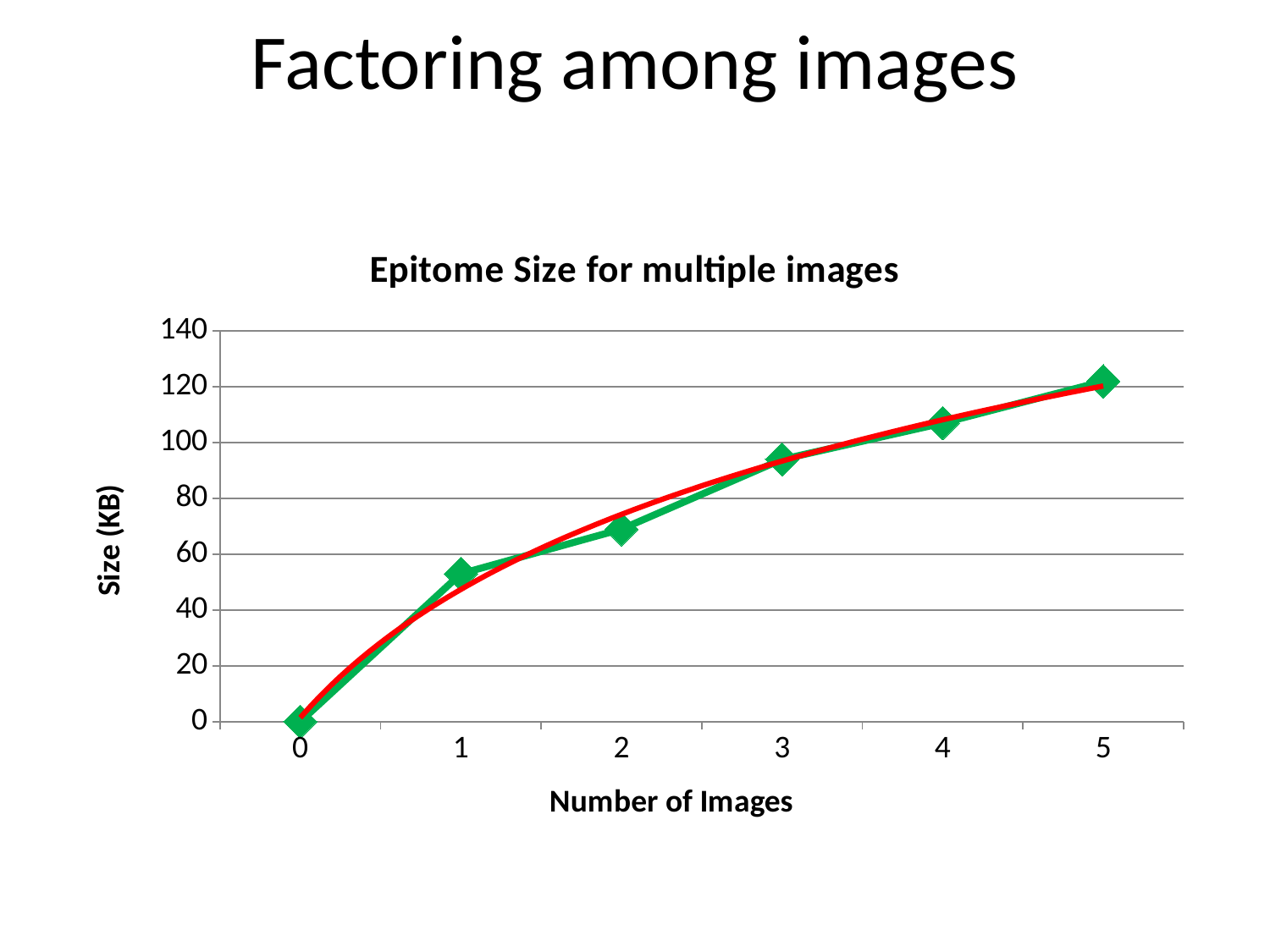
What is the size in KB for 0 images? 0 Is the value for 1 image greater or less than 40? greater At which number of images is the size highest? 5 At which number of images is the size lowest? 0 Is the value for 2 images greater or less than 80? less How many data points are plotted on the green line? 6 Which has a larger size, 3 images or 4 images? 4 images What kind of chart is shown on the slide? line chart What is the label of the y axis? Size (KB) What is the title of the chart? Epitome Size for multiple images Do the values rise or fall as the number of images increases? rise